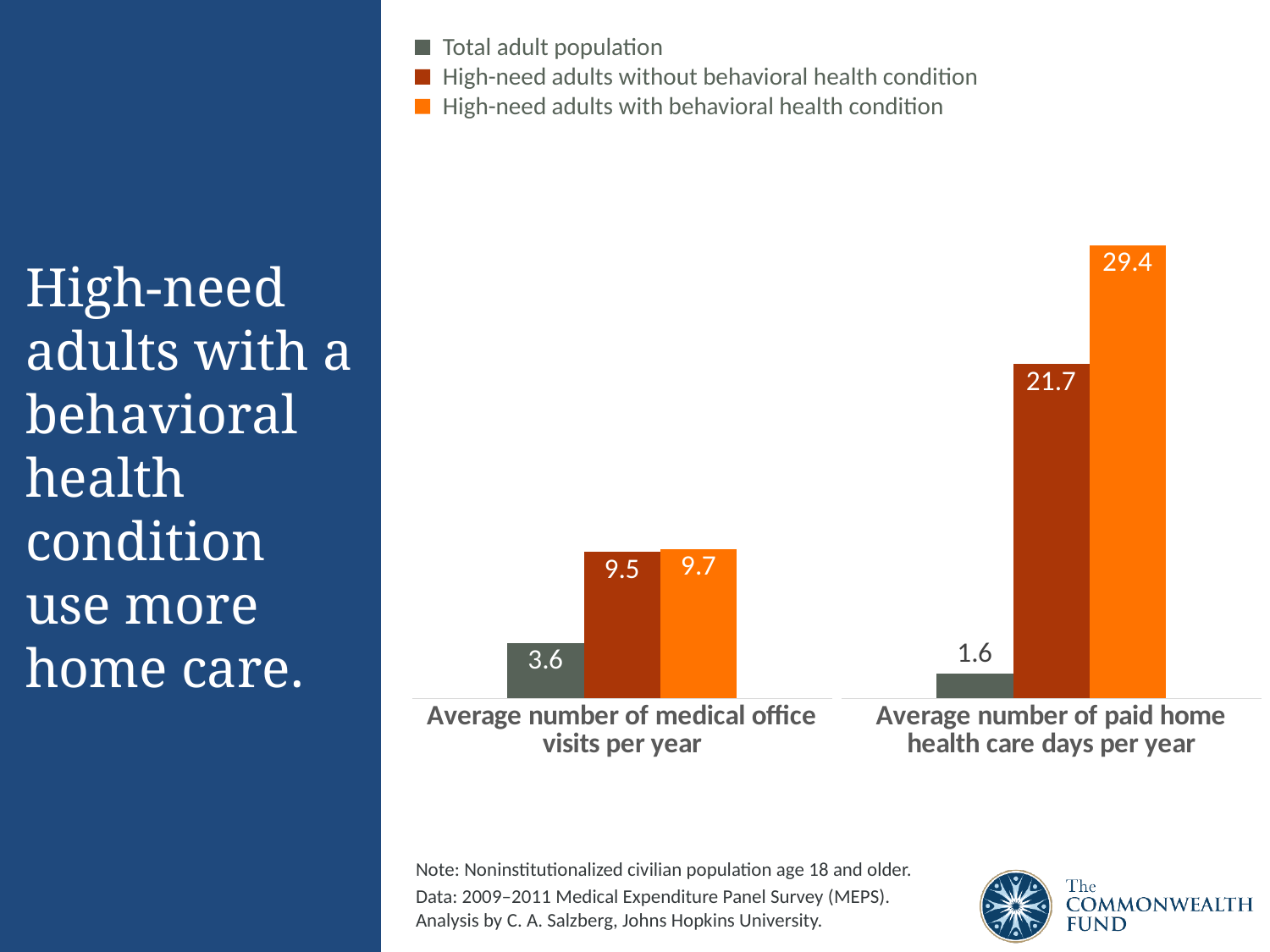
Which is larger: the average number of paid home health care days per year for the total adult population or for high-need adults without a behavioral health condition? High-need adults without behavioral health condition What is the average number of paid home health care days per year for high-need adults with a behavioral health condition? 29.4 What is the difference in average medical office visits per year between high-need adults without a behavioral health condition and the total adult population? 5.9 Which group has the lowest average number of medical office visits per year? Total adult population How many series does the legend list? 3 What is the average number of medical office visits per year for the total adult population? 3.6 What kind of chart is shown on the slide? Bar chart Which group has the highest average number of paid home health care days per year? High-need adults with behavioral health condition How many categories are shown on the x axis? 2 What is the average number of medical office visits per year for high-need adults with a behavioral health condition? 9.7 What is the difference in average paid home health care days per year between high-need adults with and without a behavioral health condition? 7.7 What is the average number of paid home health care days per year for high-need adults without a behavioral health condition? 21.7